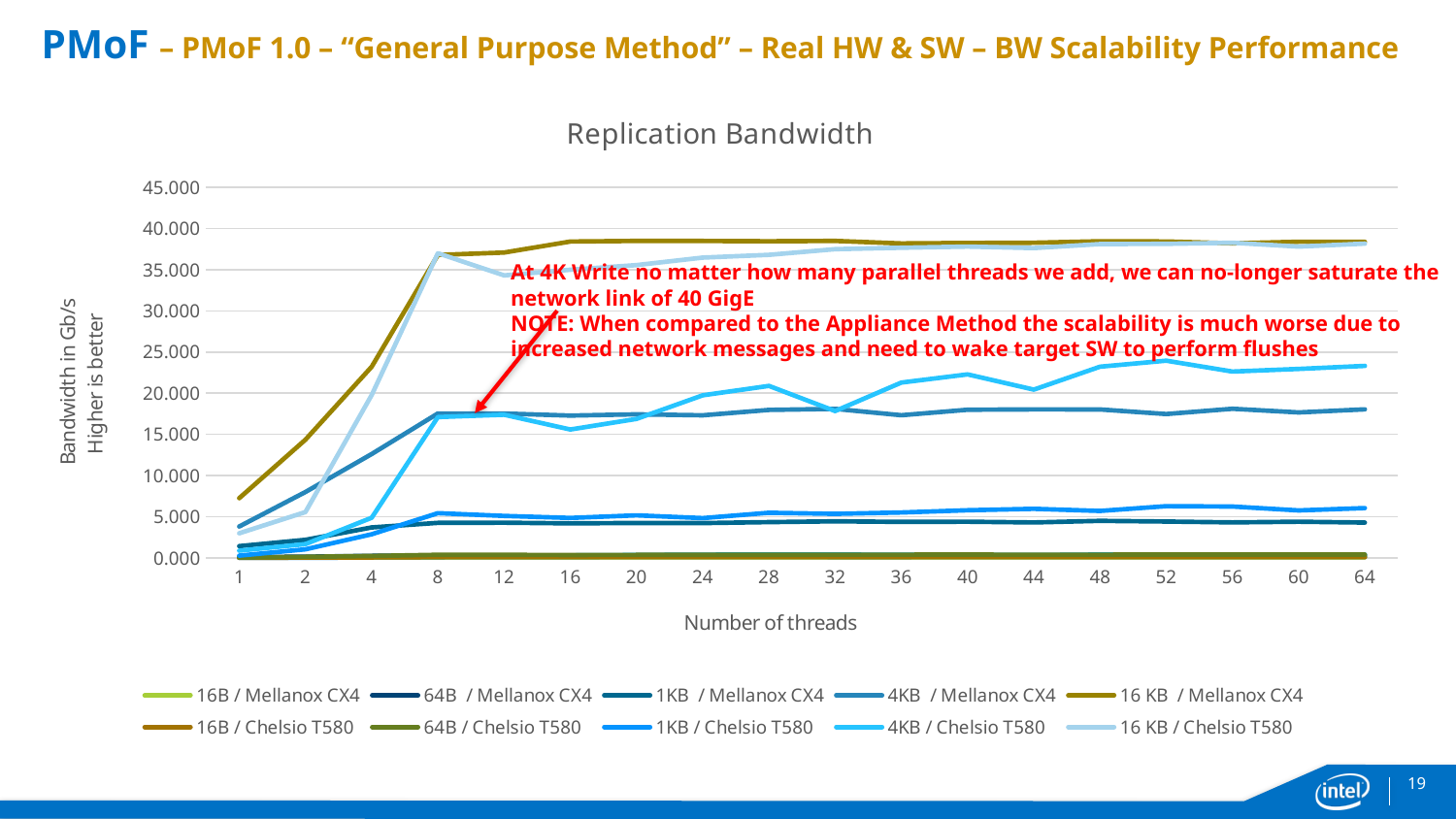
How many thread-count points are shown along the x axis of the Replication Bandwidth chart? 18 Is the value for 16 KB / Mellanox CX4 at 64 threads greater or less than 35.000? greater How many series does the legend of the Replication Bandwidth chart list? 10 At 64 threads, which is higher: 4KB / Chelsio T580 or 4KB / Mellanox CX4? 4KB / Chelsio T580 Is the value for 16 KB / Mellanox CX4 at 1 thread greater or less than 10.000? less Is the value for 4KB / Mellanox CX4 at 64 threads greater or less than 20.000? less Does the 16 KB / Mellanox CX4 series rise or fall from 1 thread to 8 threads? rise What is the label of the y axis of the chart? Bandwidth in Gb/s What is the title of the chart? Replication Bandwidth What type of chart is shown on the slide? line chart